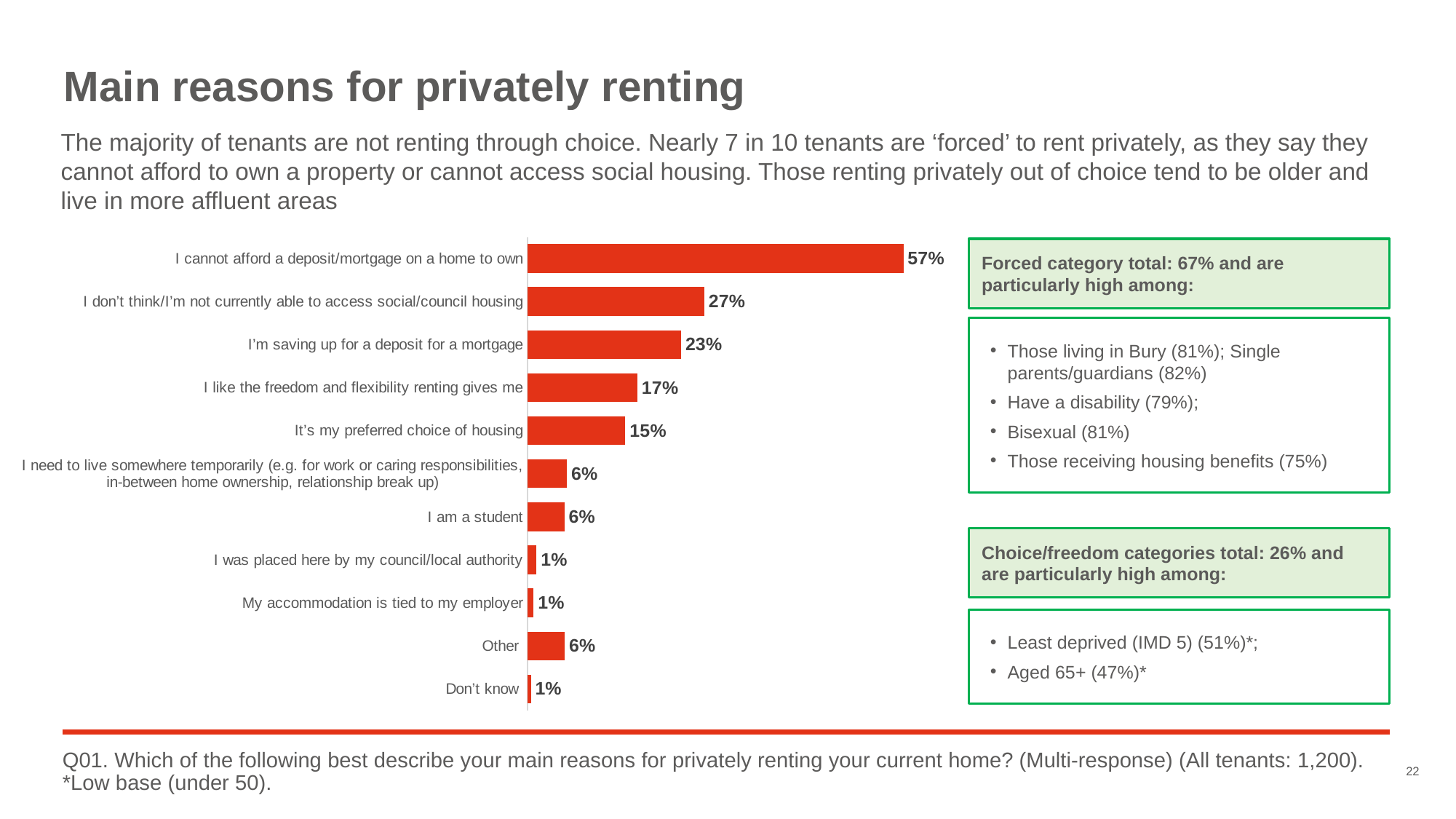
Which is larger: 'I'm saving up for a deposit for a mortgage' or 'I like the freedom and flexibility renting gives me'? I'm saving up for a deposit for a mortgage What percentage of tenants say they cannot afford a deposit/mortgage on a home to own? 57% What kind of chart is shown on the slide? Bar chart What is the difference between 'I like the freedom and flexibility renting gives me' and 'It's my preferred choice of housing'? 2% Which reason has the highest percentage? I cannot afford a deposit/mortgage on a home to own What is the difference between 'I cannot afford a deposit/mortgage on a home to own' and 'I don't think/I'm not currently able to access social/council housing'? 30% What percentage of tenants say 'It's my preferred choice of housing'? 15% What percentage is shown for 'My accommodation is tied to my employer'? 1% What colour are the bars in the chart? Red What is the value for 'I'm saving up for a deposit for a mortgage'? 23% How many reasons (categories) are shown in the chart? 11 What is the value for 'I am a student'? 6%